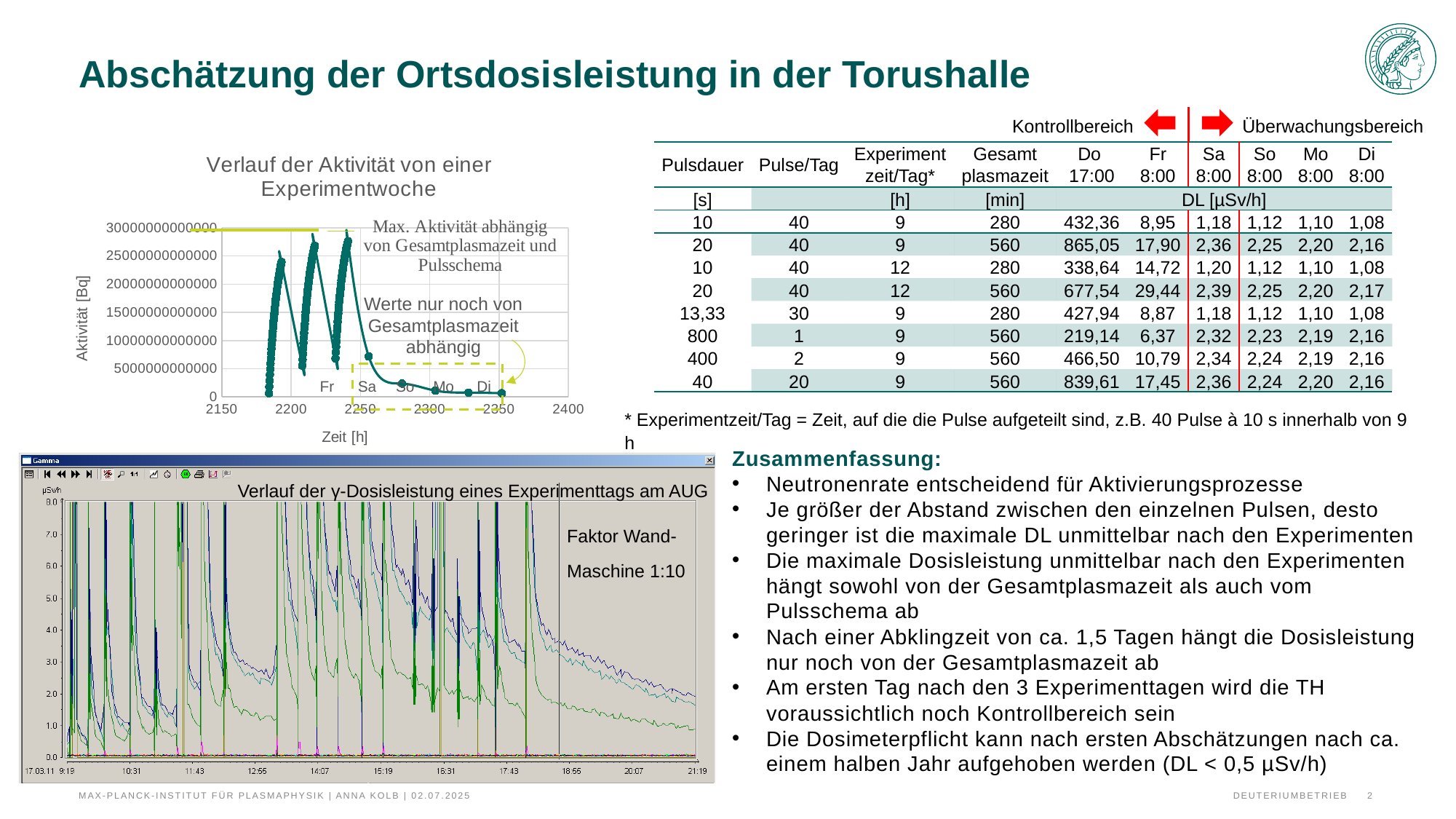
In the chart 'Verlauf der Aktivität von einer Experimentwoche', is the highest peak activity greater or less than 25000000000000 Bq? greater In the chart 'Verlauf der Aktivität von einer Experimentwoche', what is the label of the y axis? Aktivität [Bq] In the chart 'Verlauf der Aktivität von einer Experimentwoche', how many activity peaks are shown before the decay? 3 In the chart 'Verlauf der Aktivität von einer Experimentwoche', is the activity at Mo greater or less than 5000000000000 Bq? less In the chart 'Verlauf der Aktivität von einer Experimentwoche', what is the highest tick value shown on the x axis (Zeit [h])? 2400 What is the title of the chart in the upper left of the slide? Verlauf der Aktivität von einer Experimentwoche In the chart 'Verlauf der Aktivität von einer Experimentwoche', does the activity rise or fall from Sa to Di? fall In the chart 'Verlauf der Aktivität von einer Experimentwoche', which is larger, the activity at Sa or at Di? Sa In the gamma dose rate chart at the bottom left, what is the highest tick value shown on the y axis (µSv/h)? 8.0 In the chart 'Verlauf der Aktivität von einer Experimentwoche', how many day labels (Fr, Sa, So, Mo, Di) are marked along the decay curve? 5 What kind of chart is 'Verlauf der Aktivität von einer Experimentwoche'? line chart